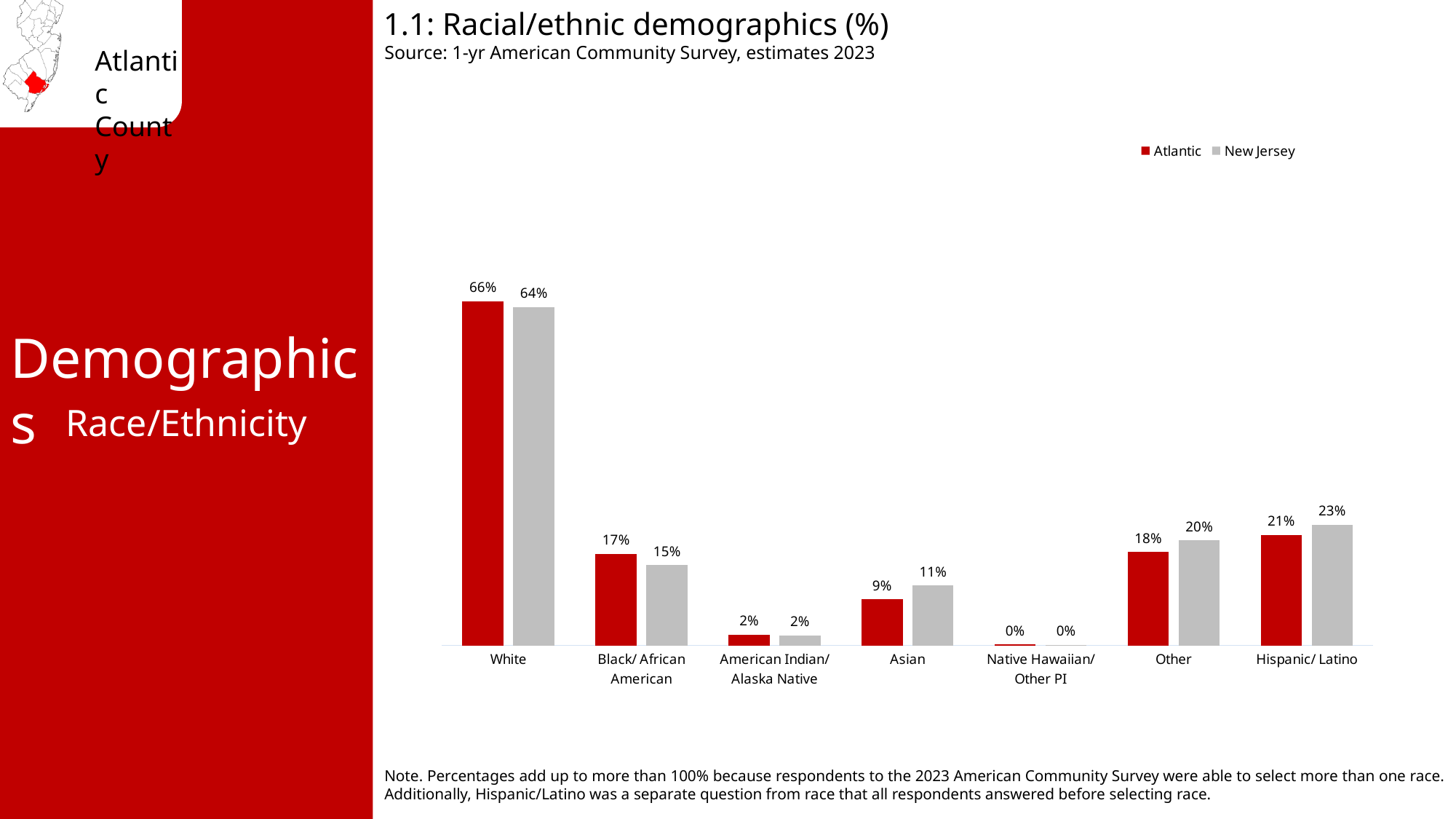
What is the difference between the Atlantic and New Jersey values for Other? 2% What is the title of the chart? 1.1: Racial/ethnic demographics (%) Which is larger for Asian, the Atlantic value or the New Jersey value? New Jersey What is the New Jersey value for Black/ African American? 15% What is the Atlantic value for Asian? 9% Which category has the highest Atlantic value? White What is the Atlantic value for White? 66% Which category has the lowest New Jersey value? Native Hawaiian/ Other PI How many series does the legend list? 2 What is the New Jersey value for Hispanic/ Latino? 23% What kind of chart is shown? bar chart How many categories are shown on the x axis? 7